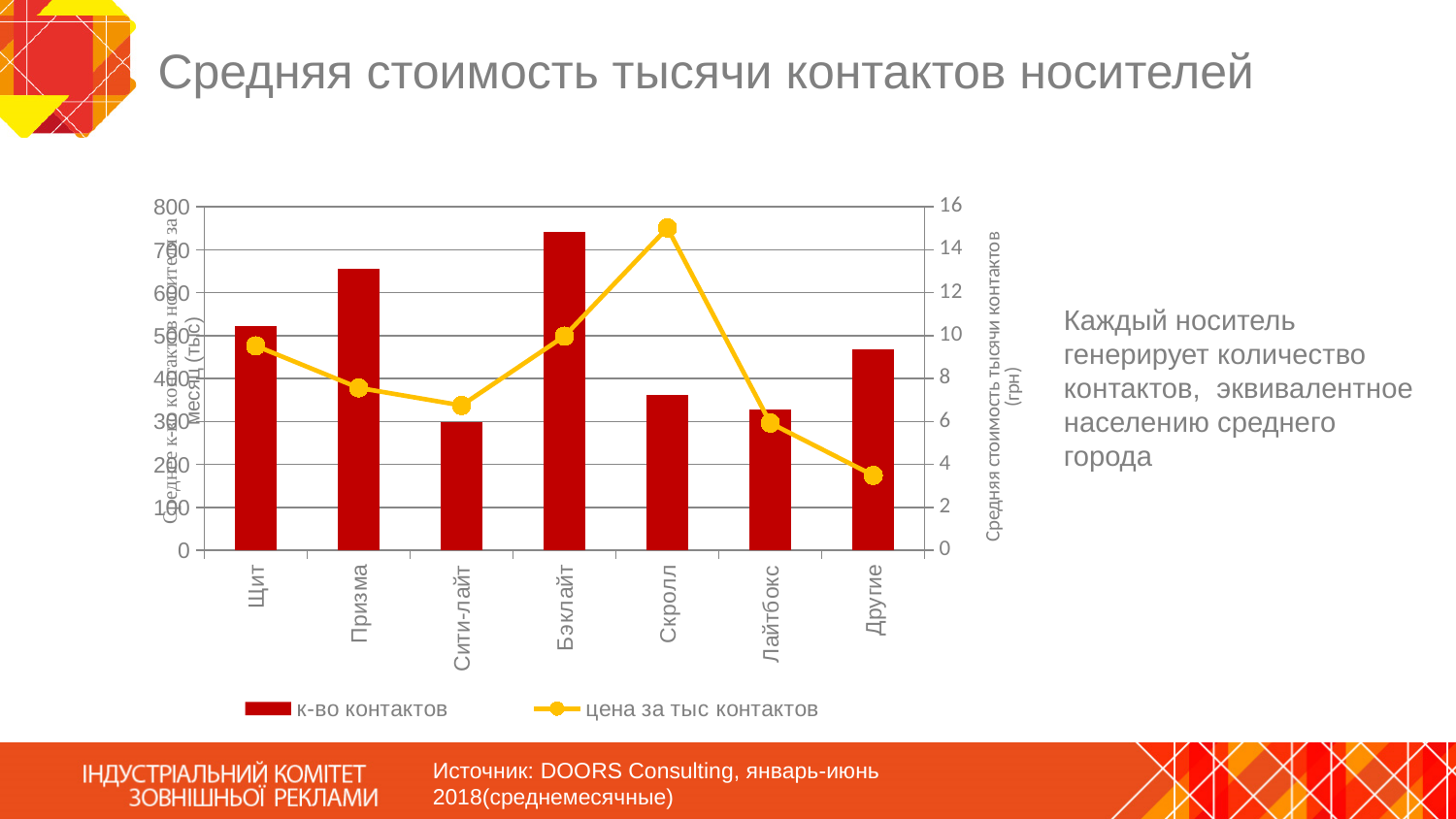
Which category has the highest value on the цена за тыс контактов line? Скролл What kind of chart is shown on the slide? Combination bar and line chart How many series does the chart legend list? 2 Which has the higher цена за тыс контактов value, Бэклайт or Лайтбокс? Бэклайт Is the цена за тыс контактов value for Другие greater or less than 4? less Is the к-во контактов bar for Бэклайт greater or less than 700? greater How many categories are shown on the x axis of the chart? 7 Is the цена за тыс контактов value for Скролл greater or less than 14? greater Which category has the tallest bar for к-во контактов? Бэклайт Which category has the lowest value on the цена за тыс контактов line? Другие Which has the larger к-во контактов bar, Щит or Призма? Призма